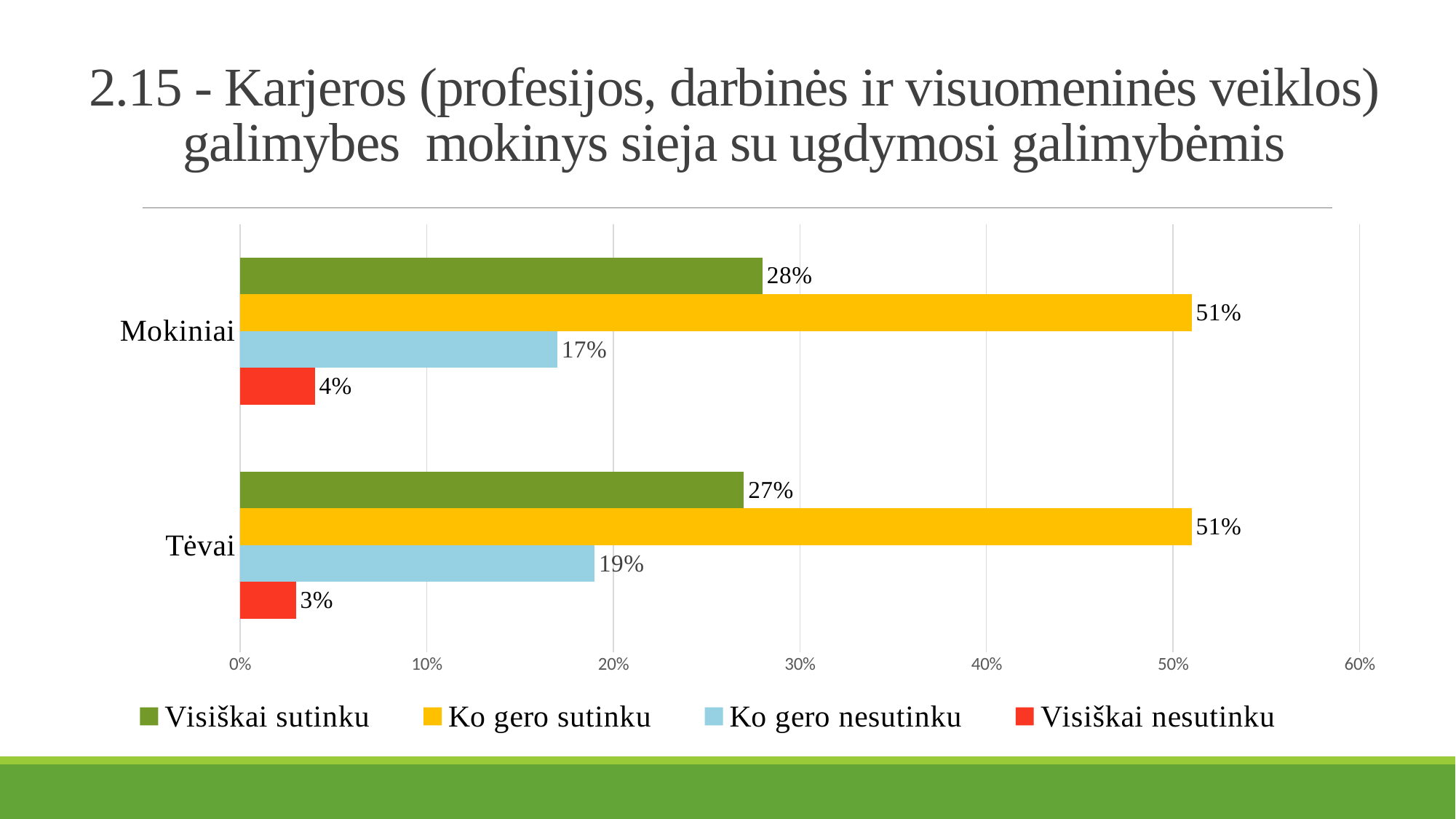
What is the value for 'Ko gero nesutinku' in the Mokiniai category? 17% What is the difference between 'Ko gero sutinku' and 'Visiškai sutinku' in the Mokiniai category? 23% Which series has the lowest value in the Mokiniai category? Visiškai nesutinku How many categories are shown on the chart? 2 Which series has the highest value in the Tėvai category? Ko gero sutinku Is the value for 'Visiškai sutinku' in the Mokiniai category greater or less than 30%? less How many series does the legend list? 4 What kind of chart is shown on the slide? Bar chart What is the value for 'Visiškai nesutinku' in the Tėvai category? 3% What is the value for 'Visiškai sutinku' in the Tėvai category? 27% Which is larger: 'Ko gero nesutinku' for Mokiniai or 'Ko gero nesutinku' for Tėvai? Tėvai What is the value for 'Ko gero sutinku' in the Mokiniai category? 51%